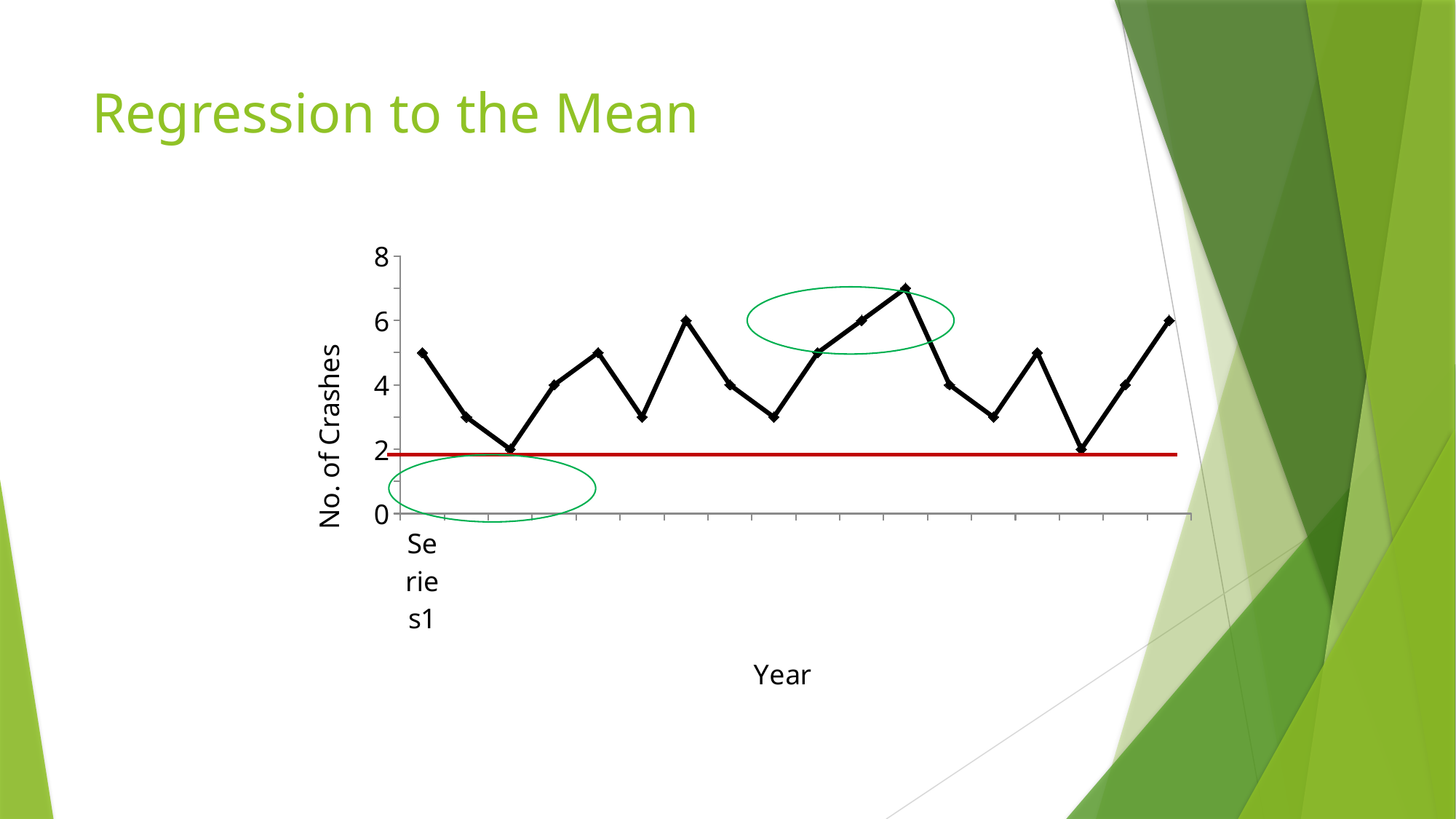
Does the line rise or fall from the first point to the second point? fall Is the red horizontal line drawn above or below the value 4 on the vertical axis? below Which is larger, the first data point or the last data point? the last data point What is the highest value shown on the vertical axis? 8 What is the title of the horizontal axis? Year What is the title of the vertical axis? No. of Crashes What is the value of the last data point on the line? 6 Is the value of the first data point greater or less than 4? greater Is the highest point on the line greater or less than 6? greater What type of chart is shown on the slide? line chart How many data points are plotted on the line? 18 What is the lowest value reached by the line? 2